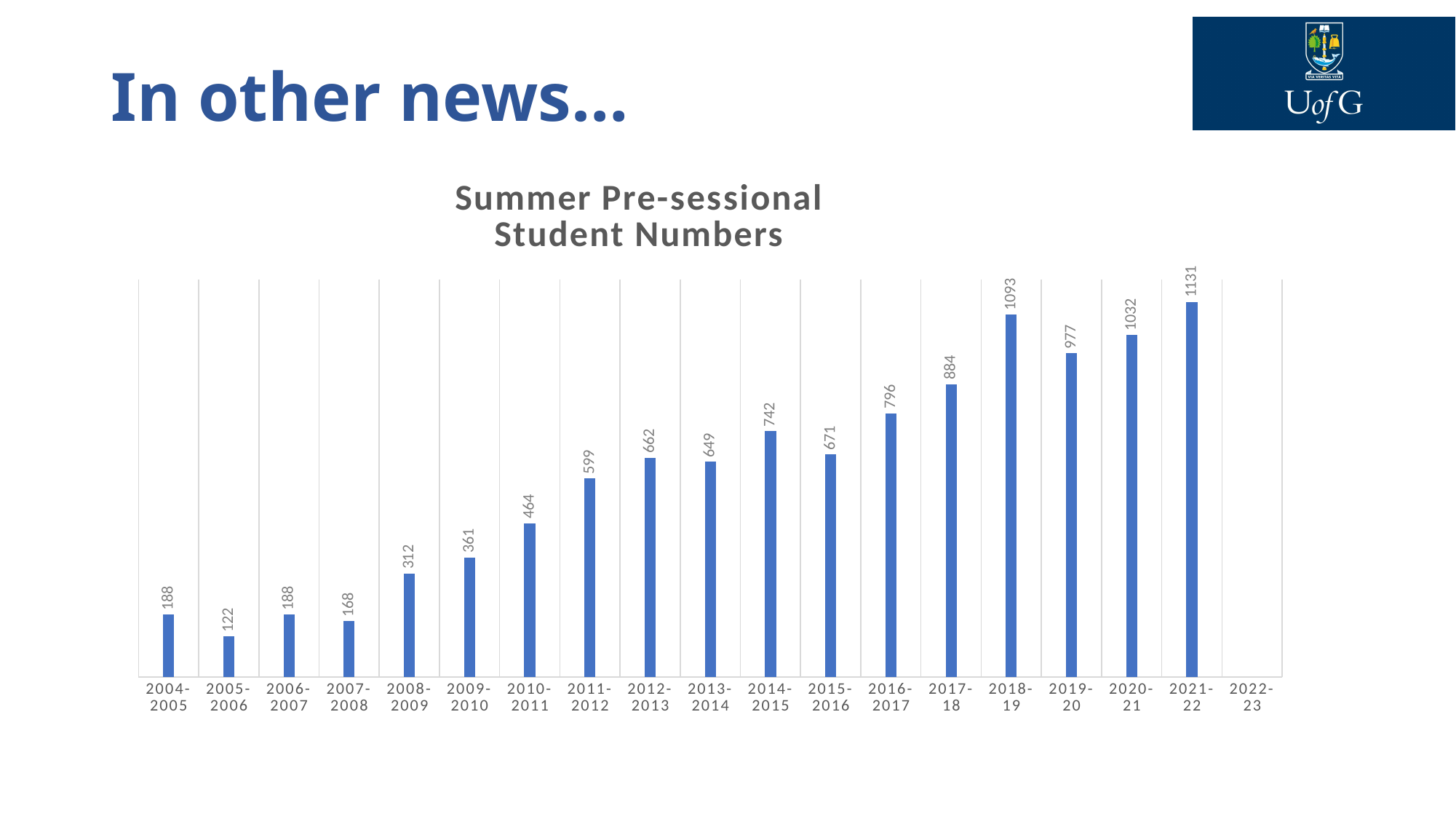
Which is larger, the value for 2014-2015 or the value for 2015-2016? 2014-2015 Which year has the highest value? 2021-22 Which is larger, the value for 2012-2013 or the value for 2013-2014? 2012-2013 What is the difference between the values for 2021-22 and 2004-2005? 943 What is the difference between the values for 2018-19 and 2019-20? 116 How many bars are plotted on the chart? 18 What kind of chart is shown? Bar chart What is the value for 2015-2016? 671 What is the value for 2021-22? 1131 Which year has the lowest value? 2005-2006 What is the value for 2008-2009? 312 What is the title of the chart? Summer Pre-sessional Student Numbers